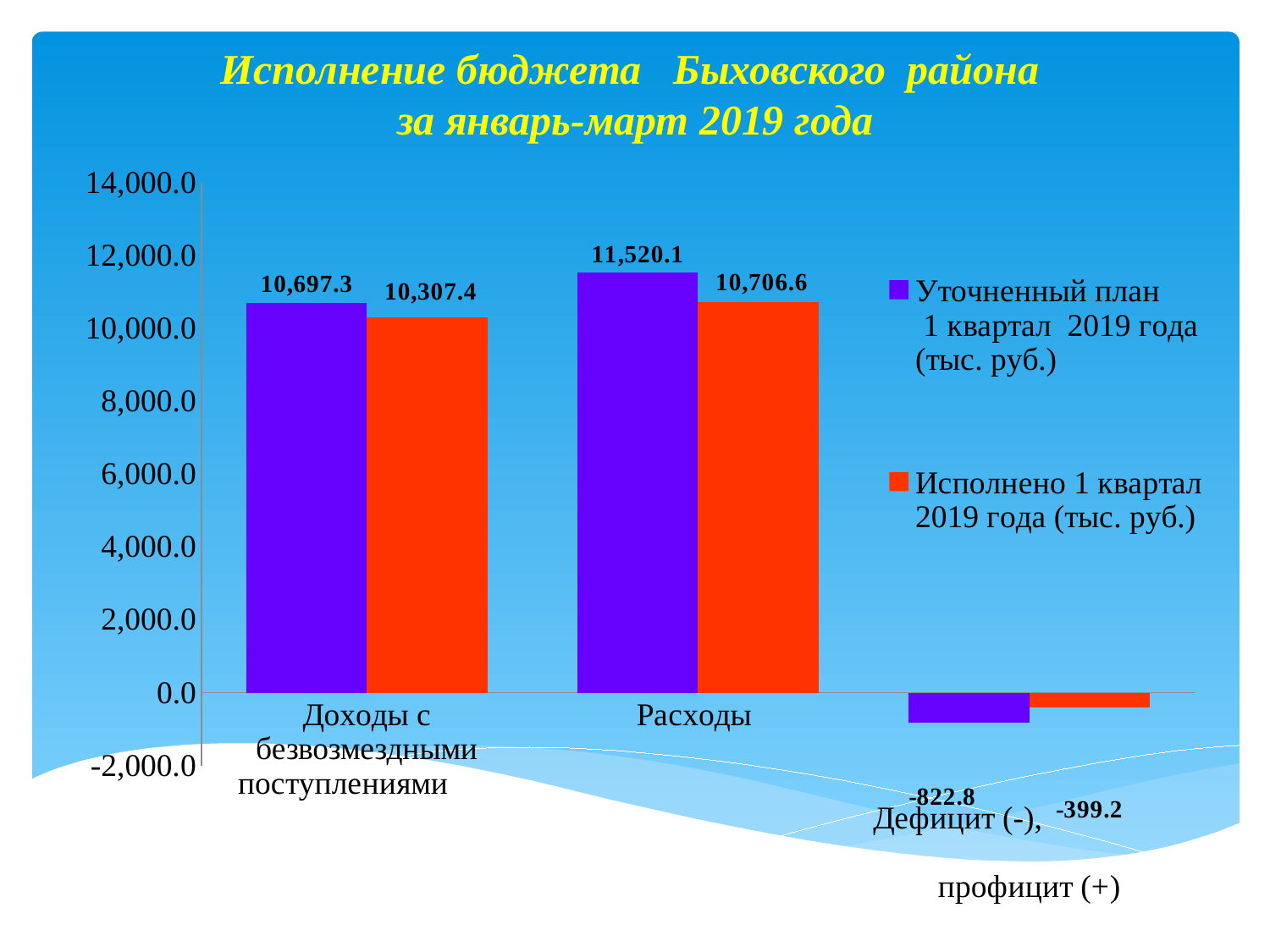
What is the difference between the 'Уточненный план' and 'Исполнено' values for 'Доходы с безвозмездными поступлениями'? 389.9 What is the difference between the 'Уточненный план' and 'Исполнено' values for 'Расходы'? 813.5 Which category has the lowest value in the 'Исполнено 1 квартал 2019 года (тыс. руб.)' series? Дефицит (-), профицит (+) For 'Расходы', which is larger: the 'Уточненный план' value or the 'Исполнено' value? Уточненный план How many categories are shown on the x axis? 3 Which category has the highest value in the 'Уточненный план 1 квартал 2019 года (тыс. руб.)' series? Расходы What is the value of 'Исполнено 1 квартал 2019 года (тыс. руб.)' for 'Доходы с безвозмездными поступлениями'? 10,307.4 What is the value of 'Исполнено 1 квартал 2019 года (тыс. руб.)' for 'Дефицит (-), профицит (+)'? -399.2 What kind of chart is shown on the slide? Bar chart How many series does the legend list? 2 What is the value of 'Уточненный план 1 квартал 2019 года (тыс. руб.)' for 'Доходы с безвозмездными поступлениями'? 10,697.3 What is the value of 'Уточненный план 1 квартал 2019 года (тыс. руб.)' for 'Расходы'? 11,520.1